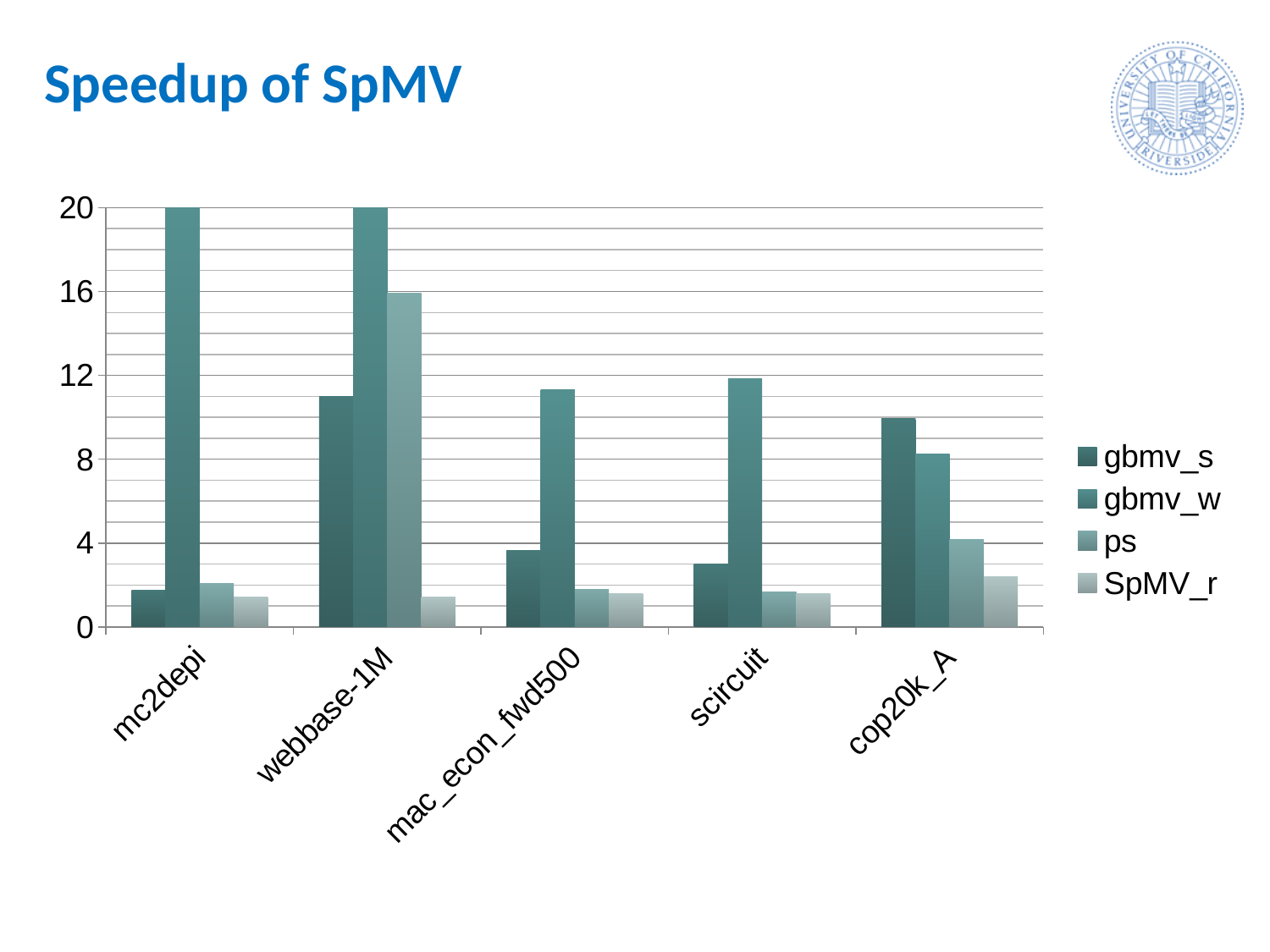
Is the gbmv_s value for webbase-1M greater or less than 8? greater How many categories are shown on the x axis of the chart? 5 What is the title of the slide containing the chart? Speedup of SpMV What kind of chart is shown on the slide? bar chart For scircuit, which is larger: gbmv_s or gbmv_w? gbmv_w How many series does the chart's legend list? 4 Is the gbmv_w value for mac_econ_fwd500 greater or less than 8? greater Is the SpMV_r value for cop20k_A greater or less than 4? less For cop20k_A, which is larger: gbmv_s or gbmv_w? gbmv_s Which category has the highest ps value? webbase-1M Which category has the lowest gbmv_s value? mc2depi